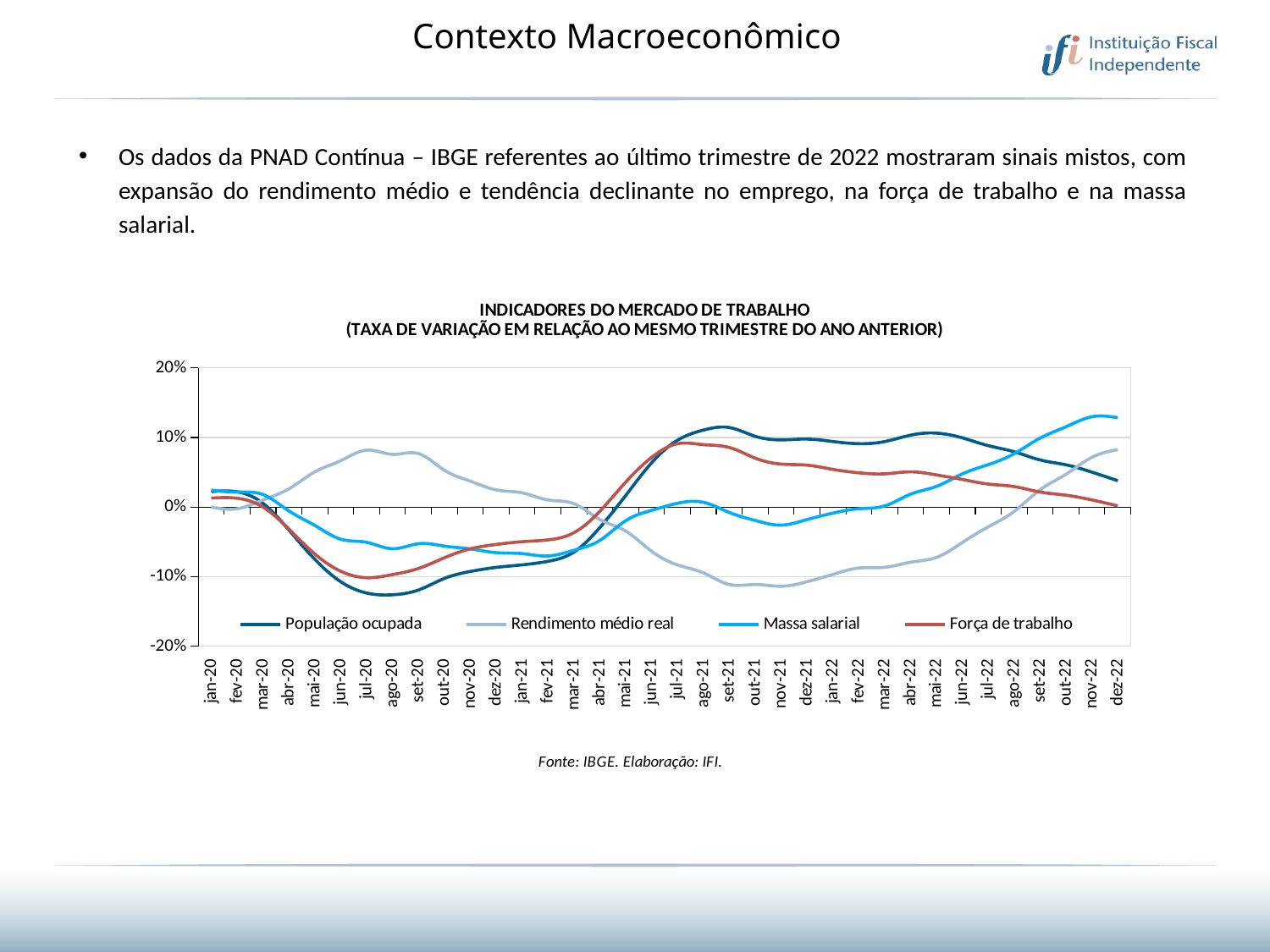
Which series has the highest value in dez-22? Massa salarial Is the value for Rendimento médio real in set-21 greater or less than -10%? less Is the value for Rendimento médio real in jul-20 greater or less than 0%? greater Which series has the lowest value in ago-20? População ocupada Is the value for População ocupada in ago-20 greater or less than -10%? less Does the Massa salarial series rise or fall from jan-22 to dez-22? Rise How many monthly points are shown along the x axis, from jan-20 to dez-22? 36 What kind of chart is shown on the slide? Line chart What is the source cited below the chart? Fonte: IBGE. Elaboração: IFI. How many series does the chart legend list? 4 In dez-22, which is larger: Massa salarial or Força de trabalho? Massa salarial